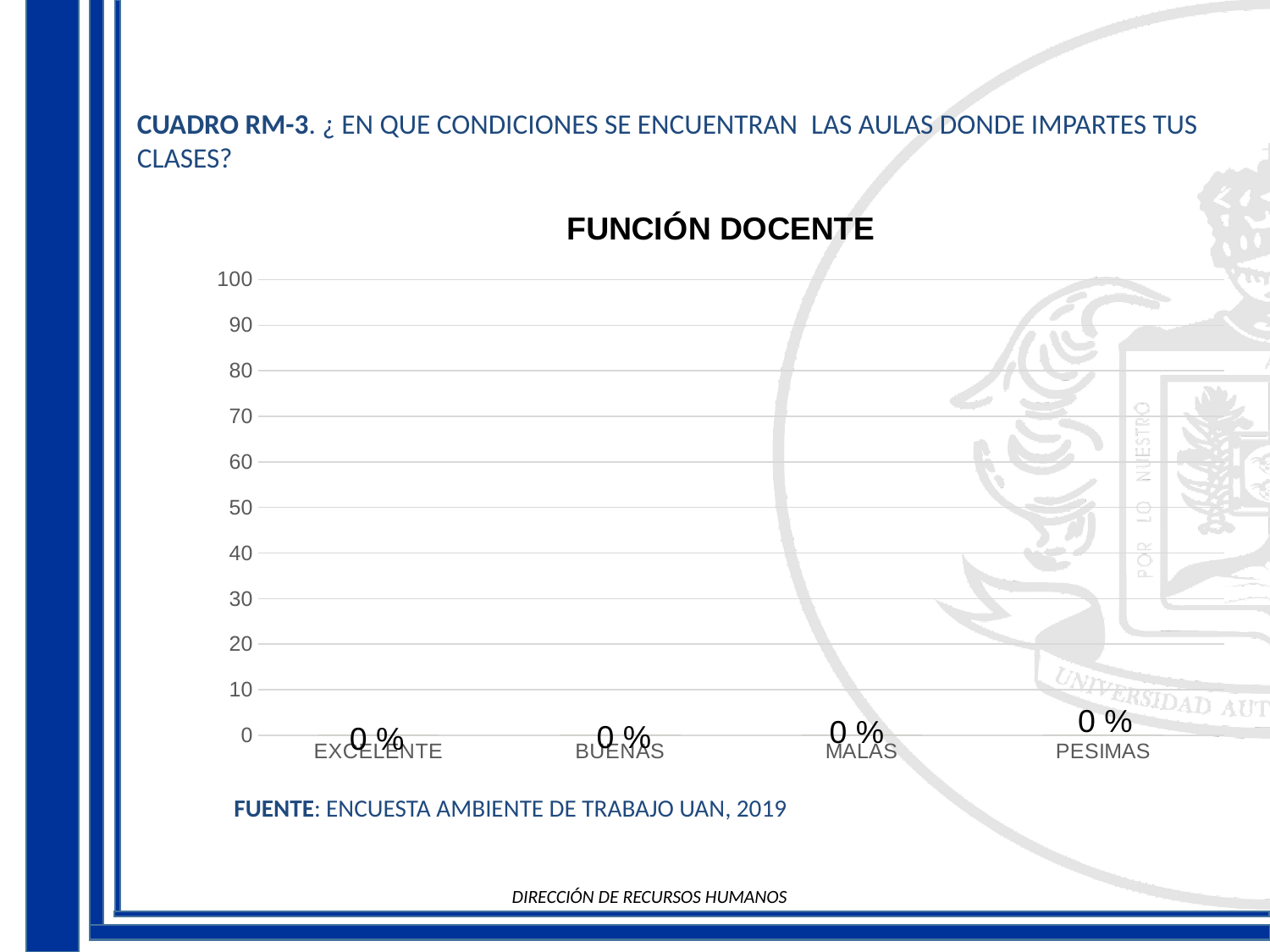
What is the title of the chart? FUNCIÓN DOCENTE What is the value shown for PESIMAS? 0 % Is the value for PESIMAS greater or less than 50? less What is the value shown for BUENAS? 0 % How many categories are shown on the x axis of the chart? 4 Do the values rise, fall, or stay the same across the categories from EXCELENTE to PESIMAS? stay the same Is the value for EXCELENTE greater or less than 10? less What is the highest value shown on the chart's y axis? 100 What is the value shown for EXCELENTE? 0 % What is the value shown for MALAS? 0 %